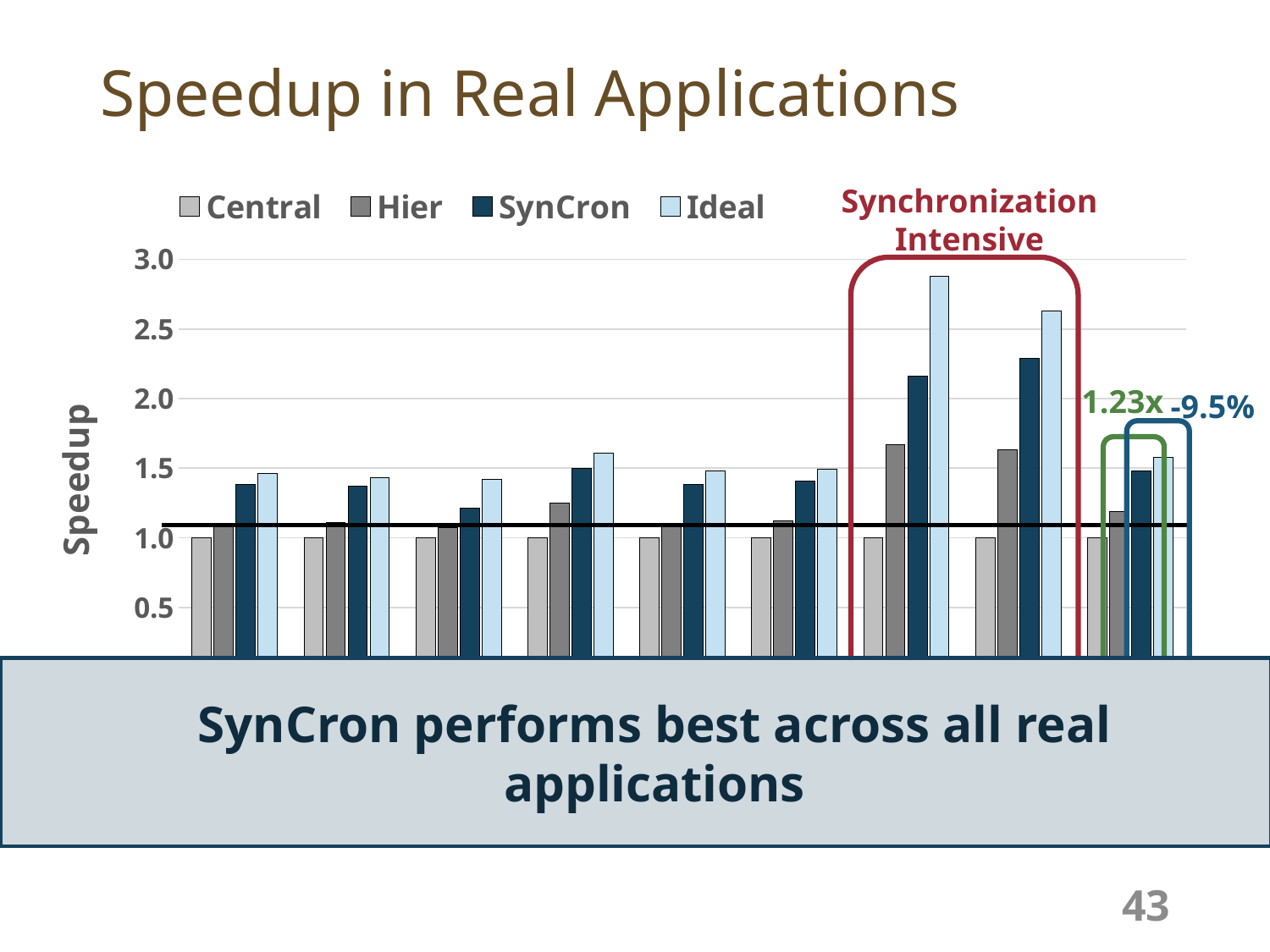
What speedup value is annotated in green above the rightmost group? 1.23x Which series has the lowest bars across all groups? Central What are the series names listed in the legend? Central, Hier, SynCron, Ideal How many groups of bars are plotted in the chart? 9 In the rightmost group of bars, which is larger, SynCron or Ideal? Ideal What percentage is annotated in blue above the rightmost group? -9.5% Is the Central value in every group greater or less than 1.5? less How many series does the legend list? 4 Which series has the tallest bar in the chart? Ideal What kind of chart is shown on the slide? bar chart What is the label on the y axis? Speedup Is the tallest Ideal bar greater or less than 2.5? greater